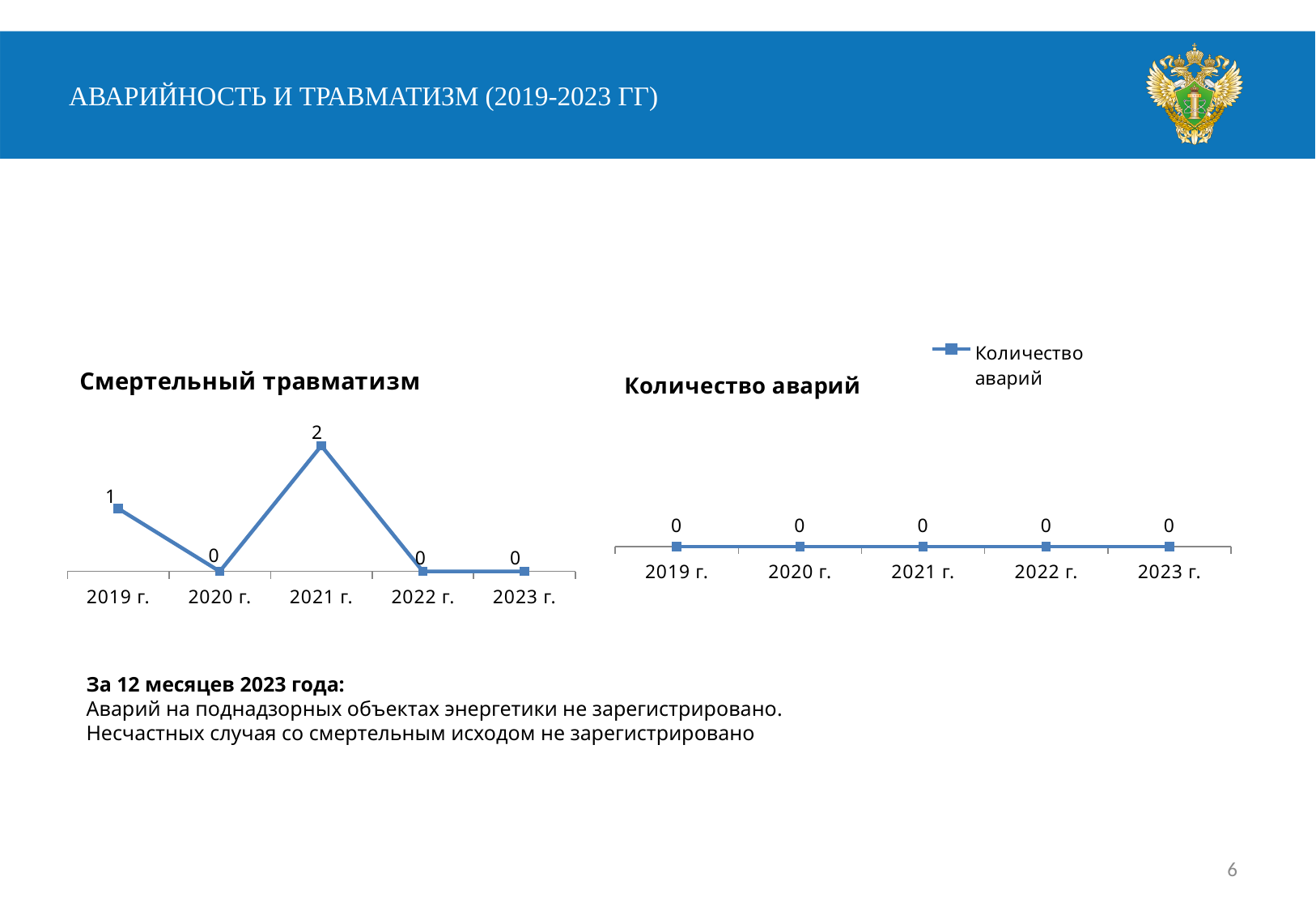
In the 'Смертельный травматизм' chart, does the value rise or fall from 2021 г. to 2022 г.? fall In the 'Смертельный травматизм' chart, which year has the highest value? 2021 г. In the 'Смертельный травматизм' chart, what is the value for 2021 г.? 2 In the 'Количество аварий' chart, what is the value for 2022 г.? 0 What kind of chart is the 'Количество аварий' chart? line chart In the 'Смертельный травматизм' chart, what is the difference between the values for 2021 г. and 2019 г.? 1 How many data points are plotted in the 'Смертельный травматизм' chart? 5 In the 'Смертельный травматизм' chart, what is the value for 2019 г.? 1 How many series does the legend of the 'Количество аварий' chart list? 1 In the 'Количество аварий' chart, what is the total of all plotted values? 0 In the 'Смертельный травматизм' chart, which is larger, the value for 2019 г. or the value for 2020 г.? 2019 г. In the 'Смертельный травматизм' chart, what is the value for 2023 г.? 0